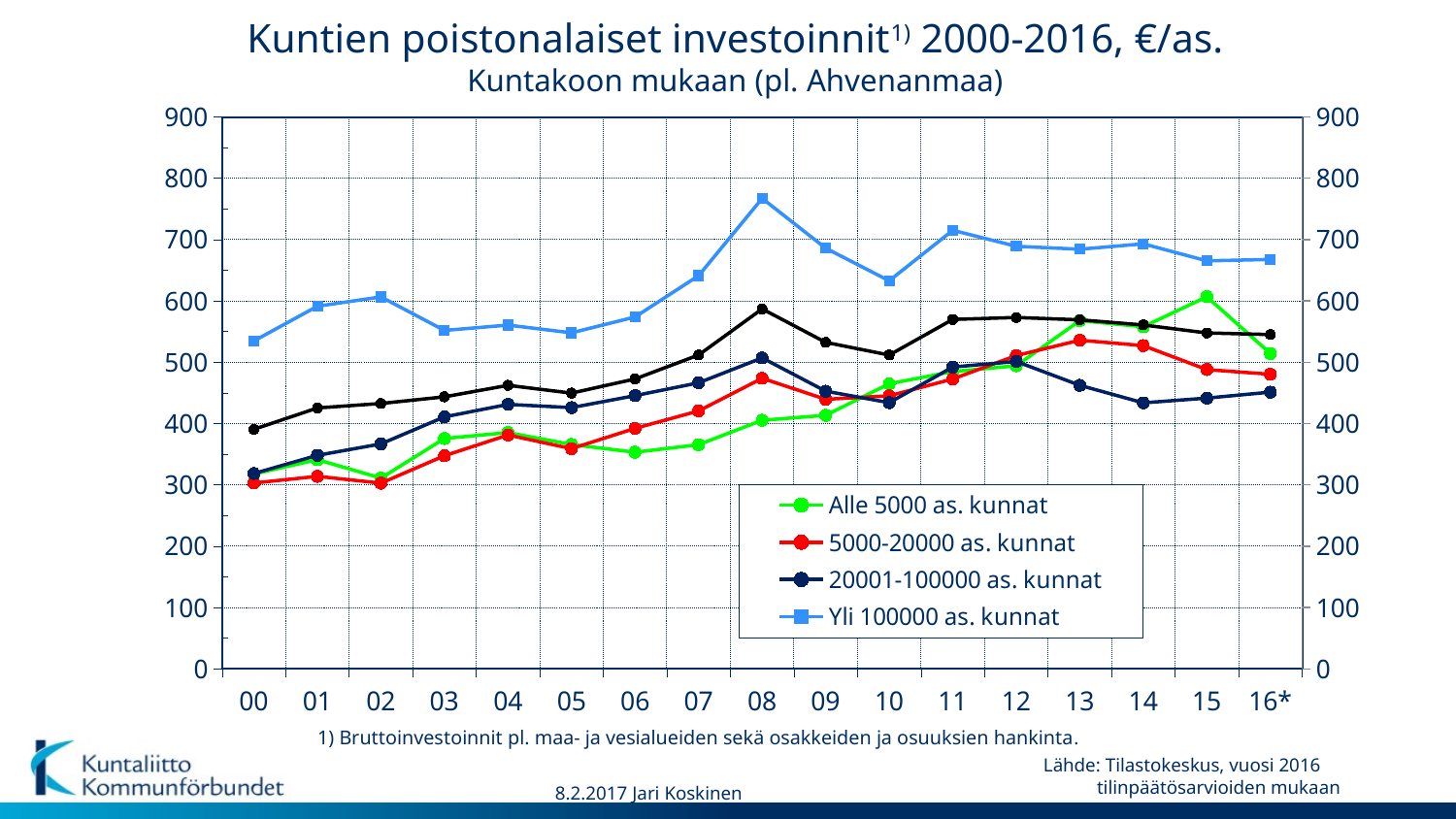
Is the value for Yli 100000 as. kunnat in 08 greater or less than 700? greater How many series does the legend list? 4 Is the value for Yli 100000 as. kunnat in 10 greater or less than 700? less In 15, which is larger: the value for Alle 5000 as. kunnat or for 5000-20000 as. kunnat? Alle 5000 as. kunnat Which series has the lowest value in 14? 20001-100000 as. kunnat Is the value for 5000-20000 as. kunnat in 02 greater or less than 400? less Which series has the highest value in 08? Yli 100000 as. kunnat How many years are shown along the x axis? 17 Does the value for Yli 100000 as. kunnat rise or fall from 05 to 08? rise Which series is drawn in green? Alle 5000 as. kunnat What kind of chart is shown on the slide? line chart